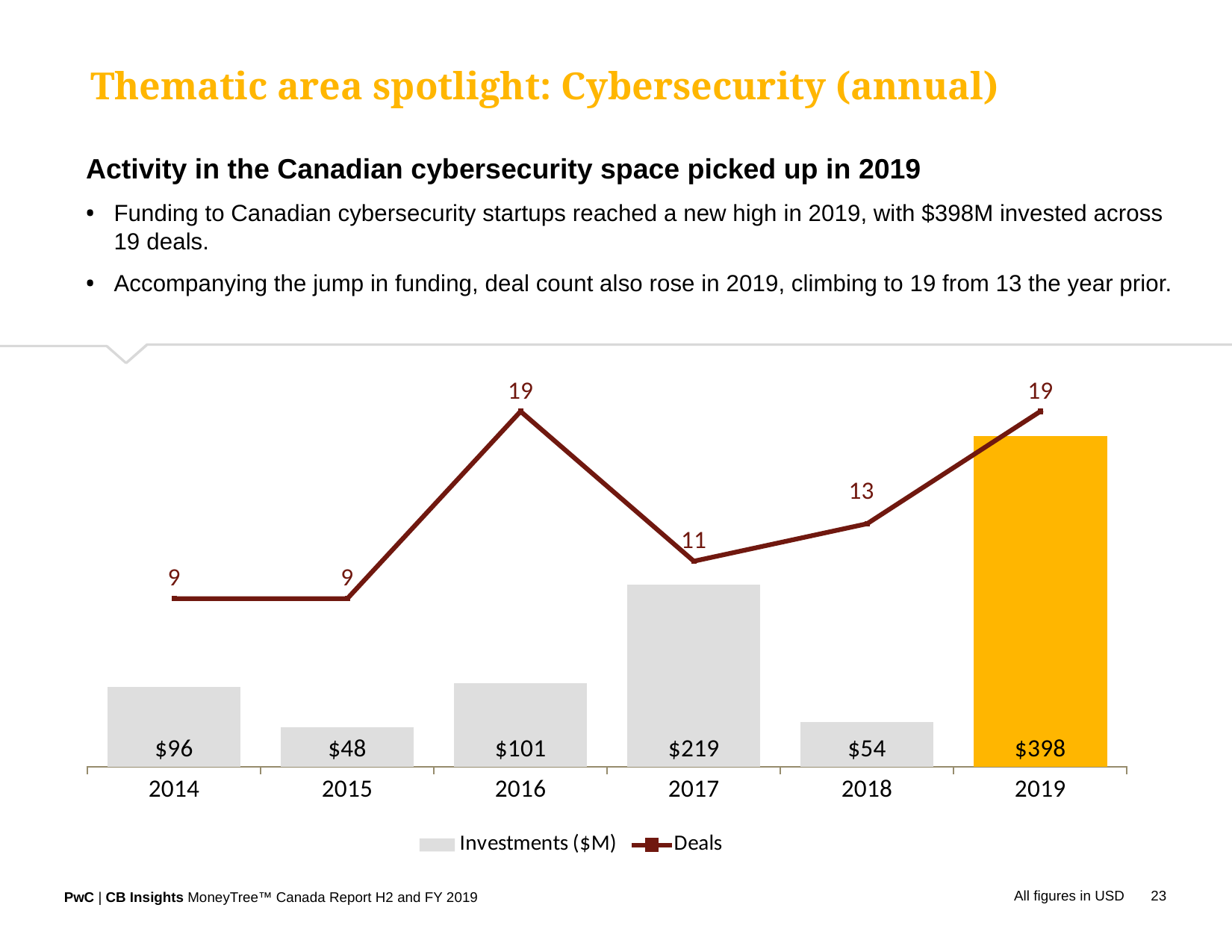
What kind of chart is shown on the slide? Combined bar and line chart How many years are shown on the x axis? 6 What is the difference in Investments ($M) between 2019 and 2017? $179 Which year has the lowest Investments ($M)? 2015 How many series does the legend list? 2 What is the difference in Deals between 2019 and 2018? 6 What is the value of Investments ($M) for 2015? $48 Which year has the highest Investments ($M)? 2019 How many Deals were there in 2017? 11 What is the value of Investments ($M) for 2019? $398 Which year had more Deals, 2016 or 2018? 2016 Did the number of Deals rise or fall from 2017 to 2019? Rise